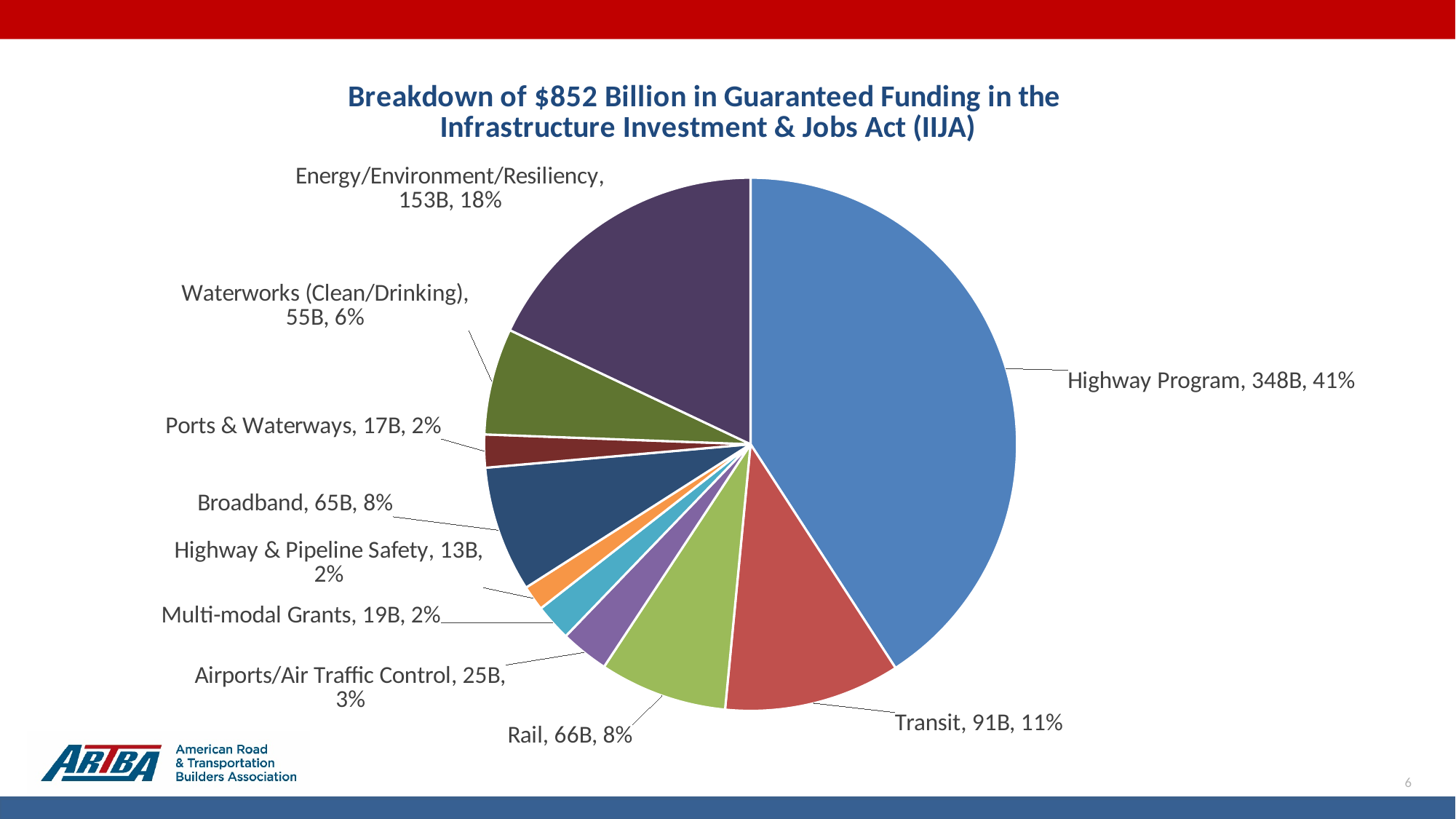
What is the funding amount for the Highway Program? 348B Which receives more funding, Rail or Broadband? Rail How many categories are shown in the pie chart? 10 Which category has the largest slice of the pie? Highway Program What is the difference in funding between the Highway Program and Transit? 257B What share of the pie does Energy/Environment/Resiliency represent? 18% What is the funding amount for Transit? 91B What share of the pie does Waterworks (Clean/Drinking) represent? 6% What is the title of the chart? Breakdown of $852 Billion in Guaranteed Funding in the Infrastructure Investment & Jobs Act (IIJA) What type of chart is shown on the slide? pie chart Which category has the smallest funding amount? Highway & Pipeline Safety What is the difference in funding between Airports/Air Traffic Control and Multi-modal Grants? 6B